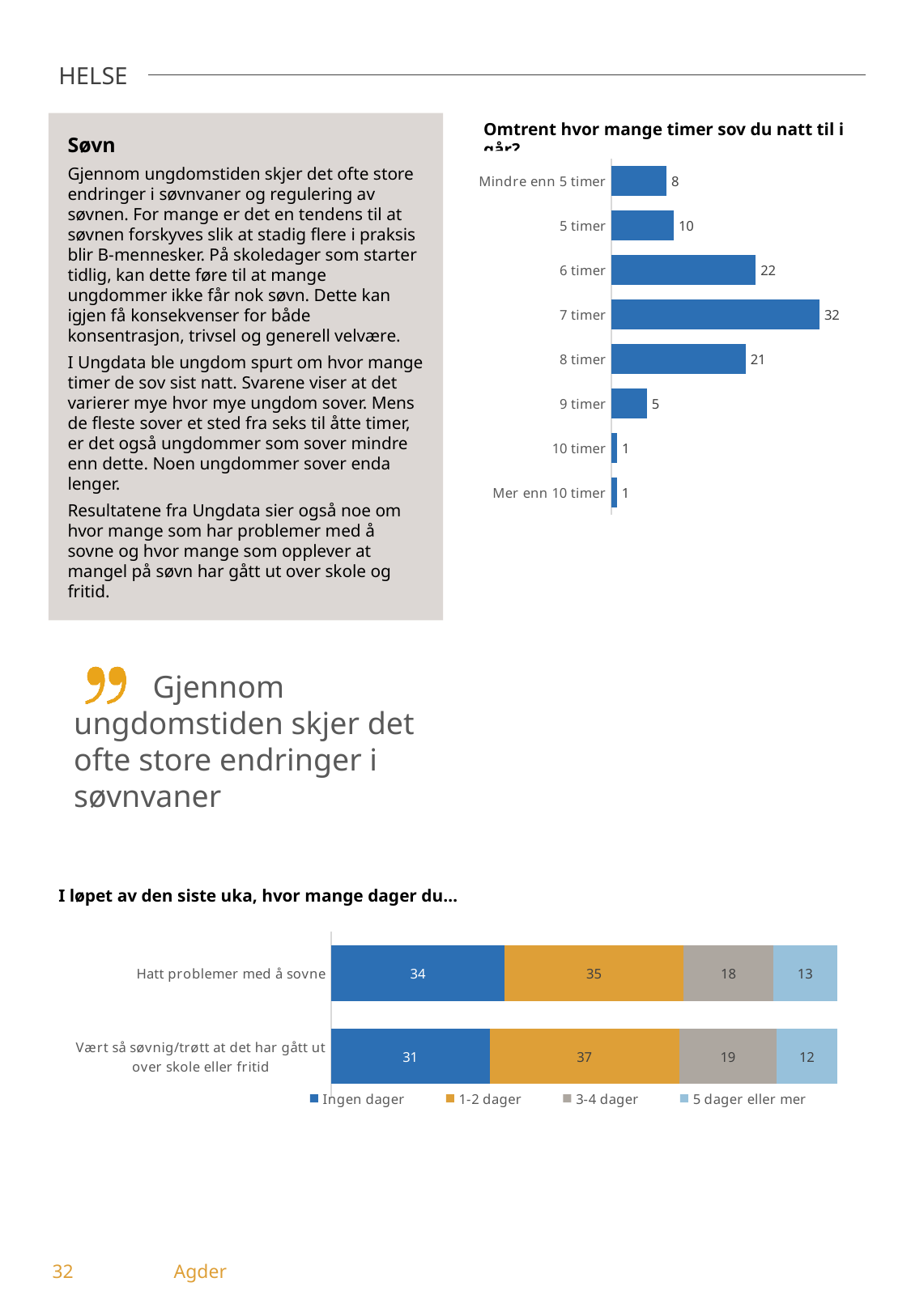
In the chart 'I løpet av den siste uka, hvor mange dager du...', what is the value of '1-2 dager' for 'Vært så søvnig/trøtt at det har gått ut over skole eller fritid'? 37 In the chart 'I løpet av den siste uka, hvor mange dager du...', what is the value of 'Ingen dager' for 'Hatt problemer med å sovne'? 34 In the chart 'Omtrent hvor mange timer sov du natt til i går?', what is the value for '7 timer'? 32 In the chart 'Omtrent hvor mange timer sov du natt til i går?', what is the value for 'Mindre enn 5 timer'? 8 In the chart 'Omtrent hvor mange timer sov du natt til i går?', what is the difference between the values for '6 timer' and '8 timer'? 1 In the chart 'I løpet av den siste uka, hvor mange dager du...', how many series does the legend list? 4 In the chart 'Omtrent hvor mange timer sov du natt til i går?', which is larger: the value for '5 timer' or the value for '9 timer'? 5 timer In the chart 'I løpet av den siste uka, hvor mange dager du...', what is the difference between the '5 dager eller mer' values for the two categories? 1 In the chart 'I løpet av den siste uka, hvor mange dager du...', what is the total of the stacked bar for 'Hatt problemer med å sovne'? 100 In the chart 'Omtrent hvor mange timer sov du natt til i går?', which category has the highest value? 7 timer In the chart 'Omtrent hvor mange timer sov du natt til i går?', how many categories are shown? 8 What kind of chart is 'Omtrent hvor mange timer sov du natt til i går?'? Bar chart